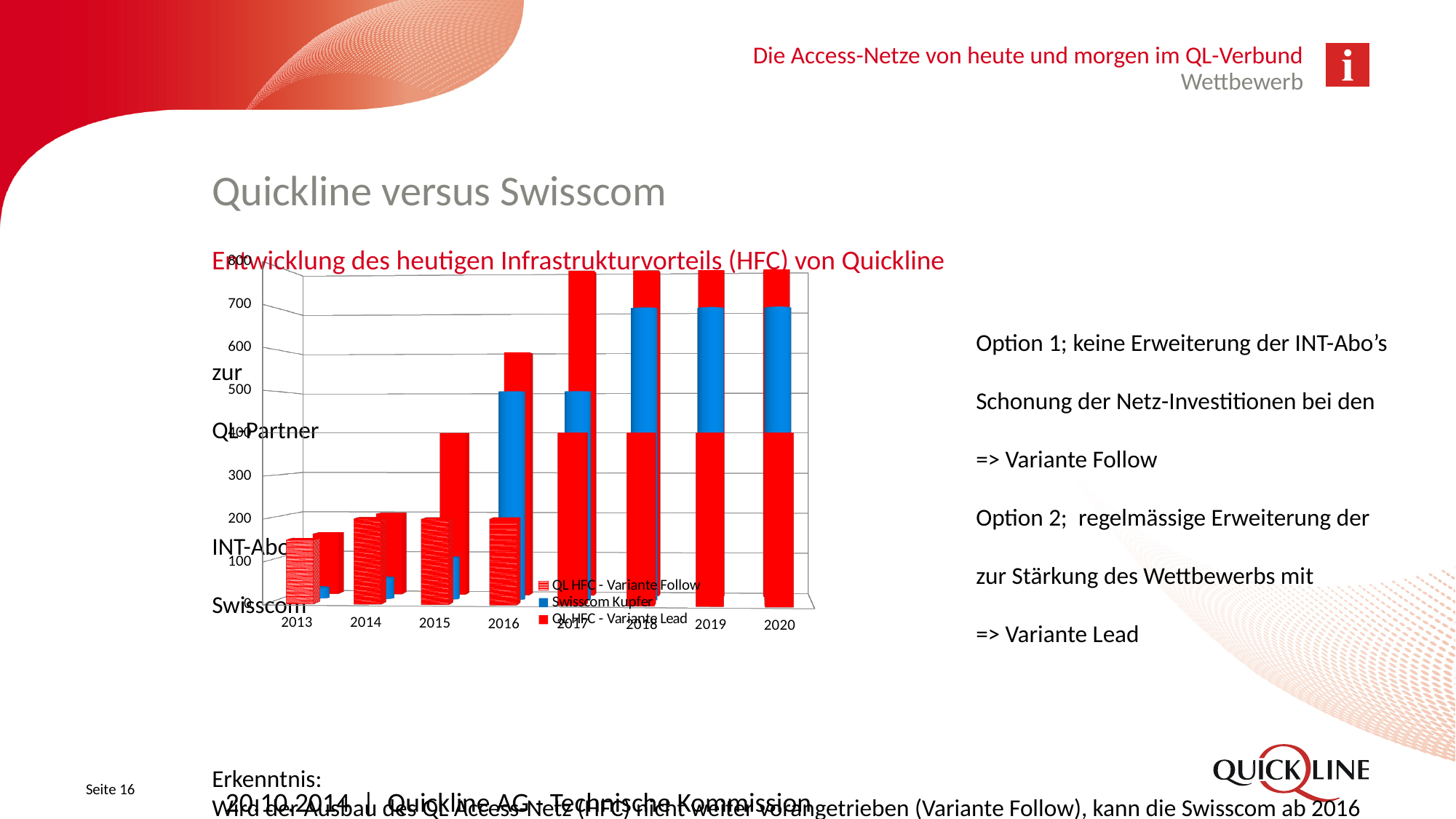
Is the value for QL HFC - Variante Lead in 2015 greater or less than 300? greater Is the value for QL HFC - Variante Lead in 2016 greater or less than 500? greater Which year has the lowest value for Swisscom Kupfer? 2013 Which colour represents Swisscom Kupfer in the chart? blue How many series does the chart legend list? 3 Is the value for Swisscom Kupfer in 2018 greater or less than 600? greater What kind of chart is shown on the slide? bar chart In 2015, which is larger: QL HFC - Variante Lead or Swisscom Kupfer? QL HFC - Variante Lead Which year has the lowest value for QL HFC - Variante Lead? 2013 Does the value for Swisscom Kupfer rise or fall from 2013 to 2019? rise How many years are shown on the x axis of the chart? 8